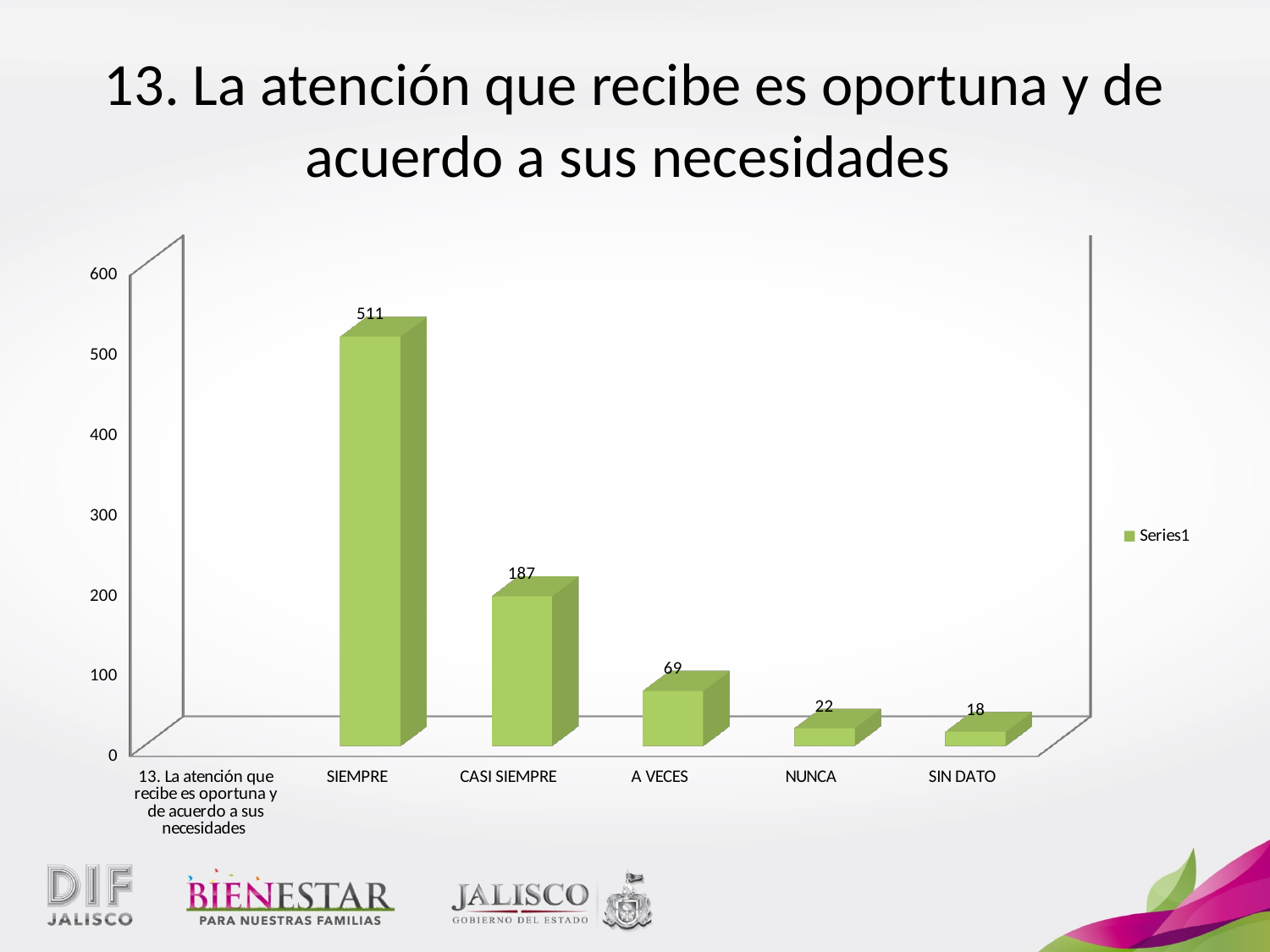
How many bars are plotted in the chart? 5 Which category has the highest value? SIEMPRE What is the value for NUNCA? 22 Which category has the lowest value among the plotted bars? SIN DATO How many series does the legend list? 1 What is the value for SIN DATO? 18 What kind of chart is shown on the slide? Bar chart What is the difference between the values for SIEMPRE and CASI SIEMPRE? 324 Which is larger, the value for A VECES or the value for NUNCA? A VECES What is the value for CASI SIEMPRE? 187 What is the value for SIEMPRE? 511 What is the value for A VECES? 69